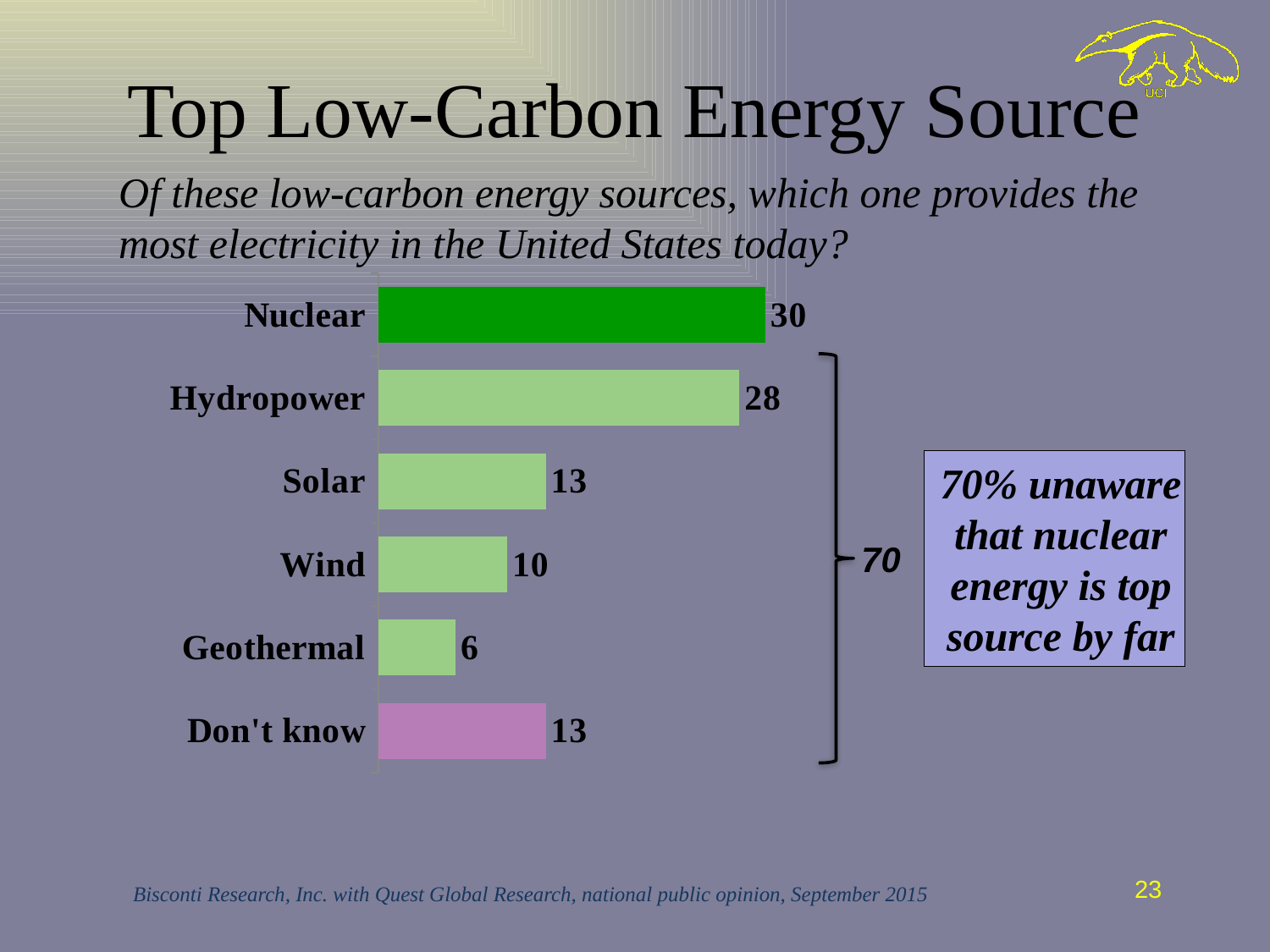
What value is shown for Don't know? 13 What is the difference between the values for Nuclear and Hydropower? 2 What is the difference between the values for Solar and Wind? 3 Which is larger, the value for Hydropower or the value for Solar? Hydropower What kind of chart is shown on the slide? Bar chart What value is shown for Hydropower? 28 What value is shown for Nuclear? 30 What value is shown for Wind? 10 How many categories are shown in the chart? 6 Which category has the highest value? Nuclear Which category has the lowest value? Geothermal What value is shown for Geothermal? 6